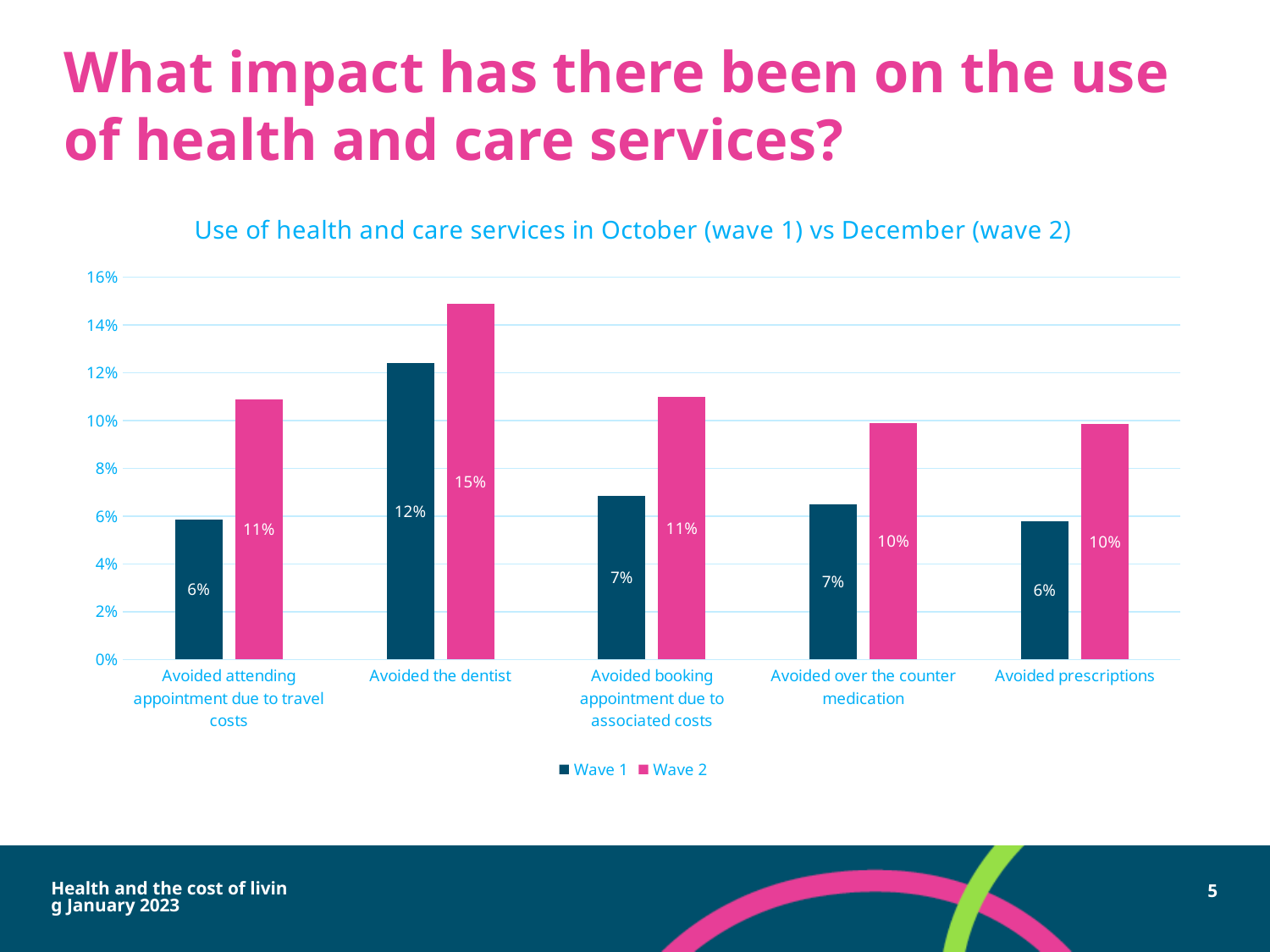
What is the Wave 2 value for 'Avoided the dentist'? 15% What is the Wave 1 value for 'Avoided booking appointment due to associated costs'? 7% How many series does the legend list? 2 What is the difference between the Wave 2 and Wave 1 values for 'Avoided the dentist'? 3 percentage points What kind of chart is shown on the slide? Bar chart What is the Wave 2 value for 'Avoided prescriptions'? 10% For 'Avoided over the counter medication', which is larger: the Wave 1 value or the Wave 2 value? Wave 2 Is the Wave 2 value for 'Avoided the dentist' greater or less than 14%? greater Which category has the highest Wave 1 value? Avoided the dentist Which category has the highest Wave 2 value? Avoided the dentist How many categories are shown on the x axis? 5 What is the Wave 1 value for 'Avoided attending appointment due to travel costs'? 6%